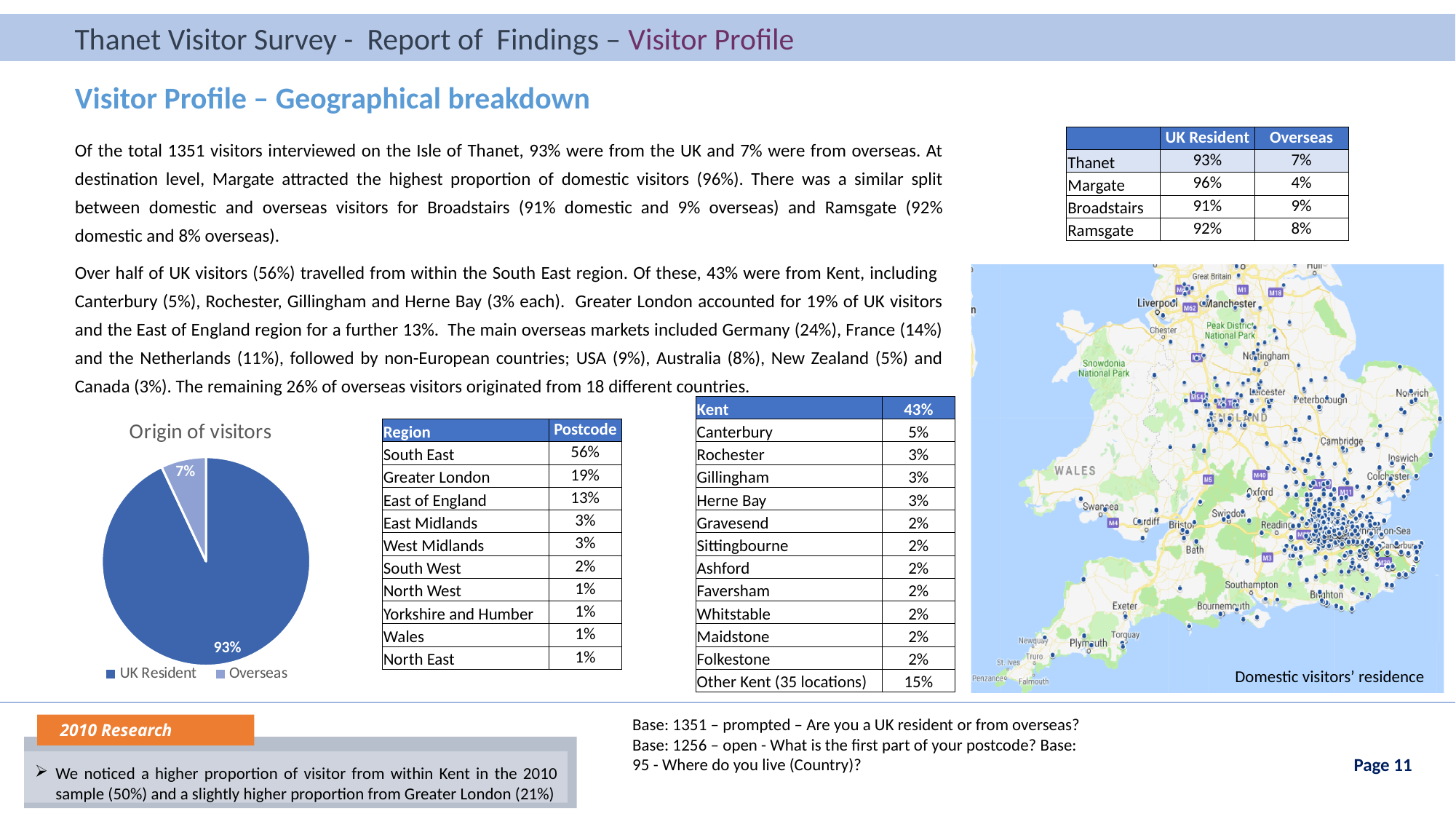
Which category has the largest slice in the "Origin of visitors" pie chart? UK Resident In the "Origin of visitors" pie chart, what is the difference in percentage points between the UK Resident and Overseas slices? 86 In the "Origin of visitors" pie chart, what share of the pie does the Overseas slice represent? 7% In the "Origin of visitors" pie chart, what share of visitors are Overseas? 7% In the "Origin of visitors" pie chart, which is larger: the UK Resident slice or the Overseas slice? UK Resident Which category has the smallest slice in the "Origin of visitors" pie chart? Overseas In the "Origin of visitors" pie chart, what share of visitors are UK Resident? 93% What is the title of the pie chart on the slide? Origin of visitors How many entries does the legend of the "Origin of visitors" pie chart list? 2 What type of chart is the "Origin of visitors" chart? pie chart How many slices does the "Origin of visitors" pie chart have? 2 What are the two legend entries of the "Origin of visitors" pie chart? UK Resident and Overseas